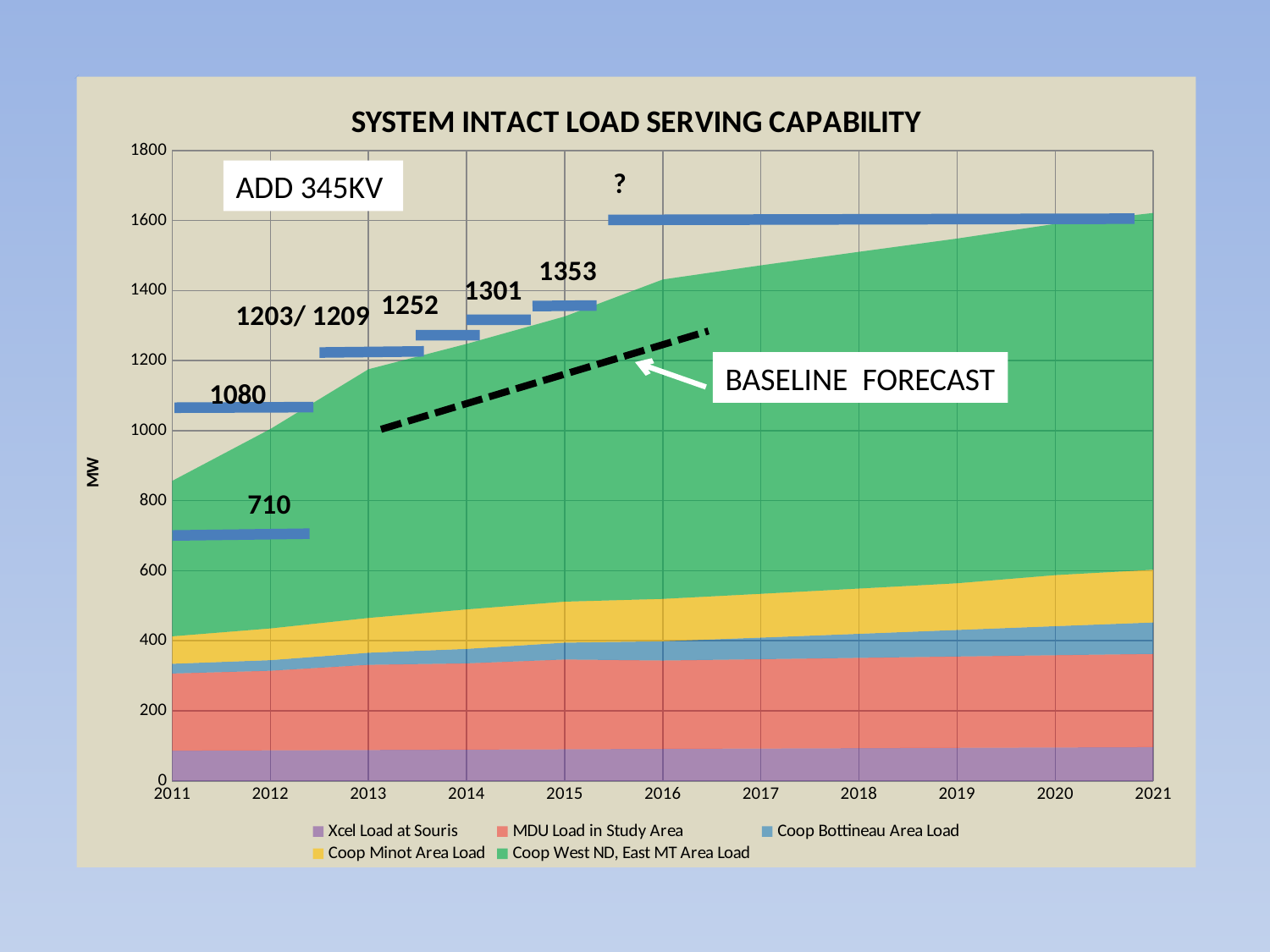
What is the title of the chart? SYSTEM INTACT LOAD SERVING CAPABILITY Does the total stacked load rise or fall from 2011 to 2021? rises Is the total stacked load in 2011 greater or less than 1000? less What is the highest numeric value labeled on the blue capability bars? 1353 What is the difference between the capability labels 1080 and 710? 370 What value is labeled on the lowest blue capability bar? 710 How many series does the legend list? 5 How many years are labeled on the x axis? 11 Is the total stacked load in 2021 greater or less than 1400? greater What is the difference between the capability labels 1353 and 1301? 52 What kind of chart is shown on the slide? stacked area chart Which is larger in 2011, Xcel Load at Souris or MDU Load in Study Area? MDU Load in Study Area